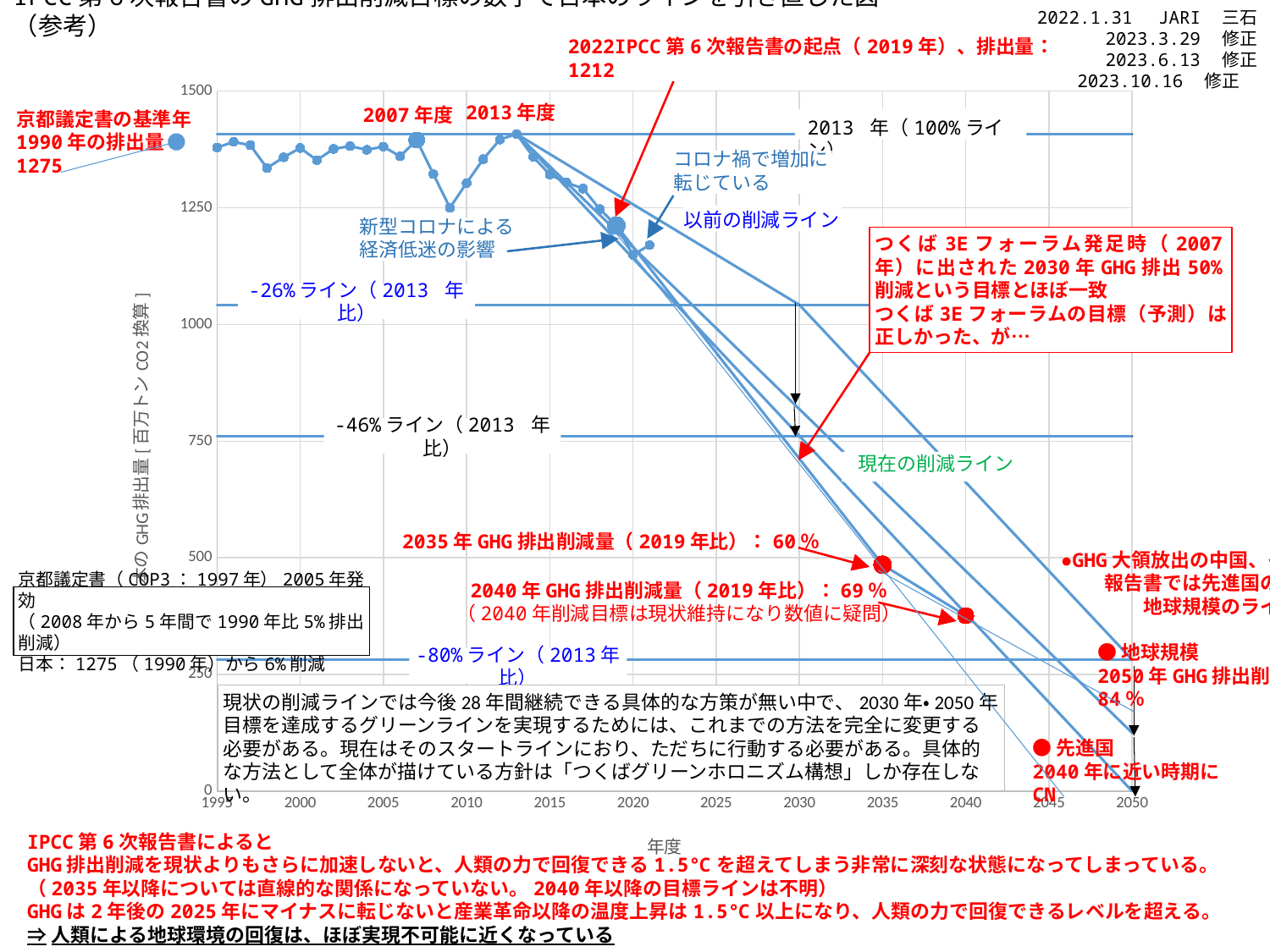
Which is larger, the 1990 base-year emission (1275) or the 2019 starting-point emission (1212)? 1990 (1275) What kind of chart is shown on the slide? line chart Is the plotted emission value for 2013 greater or less than 1250? greater What is the label of the x axis? 年度 According to the annotation, what was Japan's GHG emission in the Kyoto Protocol base year 1990? 1275 Which year is the reference for the 100% line, the -26% line, the -46% line and the -80% line? 2013 What GHG emission reduction rate (vs 2019) is annotated for 2035? 60% According to the annotation, what was the emission value at the 2022 IPCC 6th report starting point (2019)? 1212 Is the plotted emission value for 2020 greater or less than 1250? less What is the difference between the 1990 base-year emission (1275) and the 2019 emission (1212)? 63 What GHG emission reduction rate (vs 2019) is annotated for 2040? 69% What global-scale GHG emission reduction rate is annotated for 2050? 84%